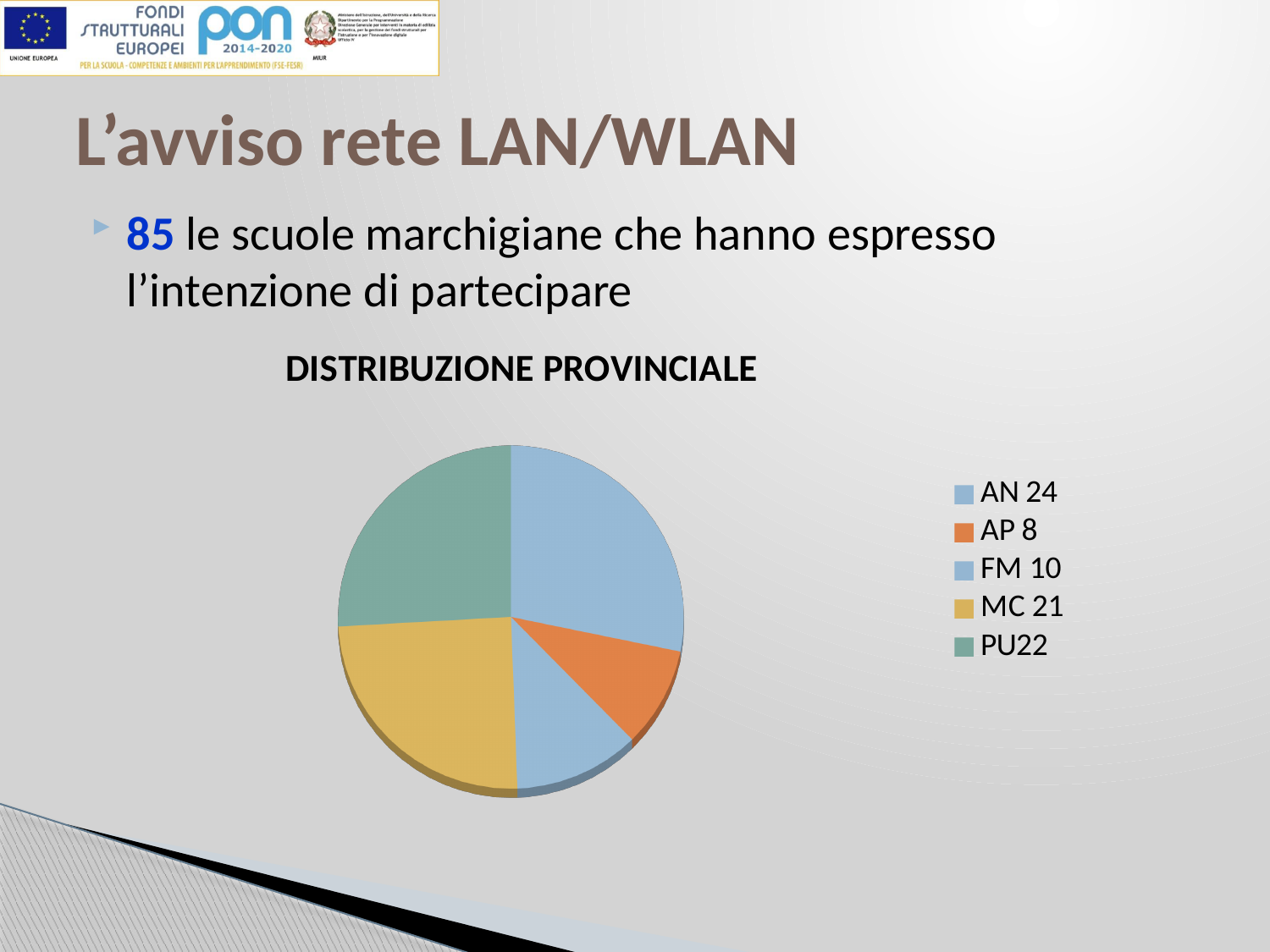
What is the value for MC in the pie chart? 21 What is the value for AN in the pie chart? 24 Which has a larger value, MC or PU? PU How many provinces (slices) does the pie chart show? 5 What is the value for AP in the pie chart? 8 What is the title of the chart? DISTRIBUZIONE PROVINCIALE What is the value for FM in the pie chart? 10 Which province has the smallest value in the pie chart? AP Which province has the largest value in the pie chart? AN What is the difference between the values for AN and AP? 16 What is the value for PU in the pie chart? 22 What type of chart is shown on the slide? Pie chart